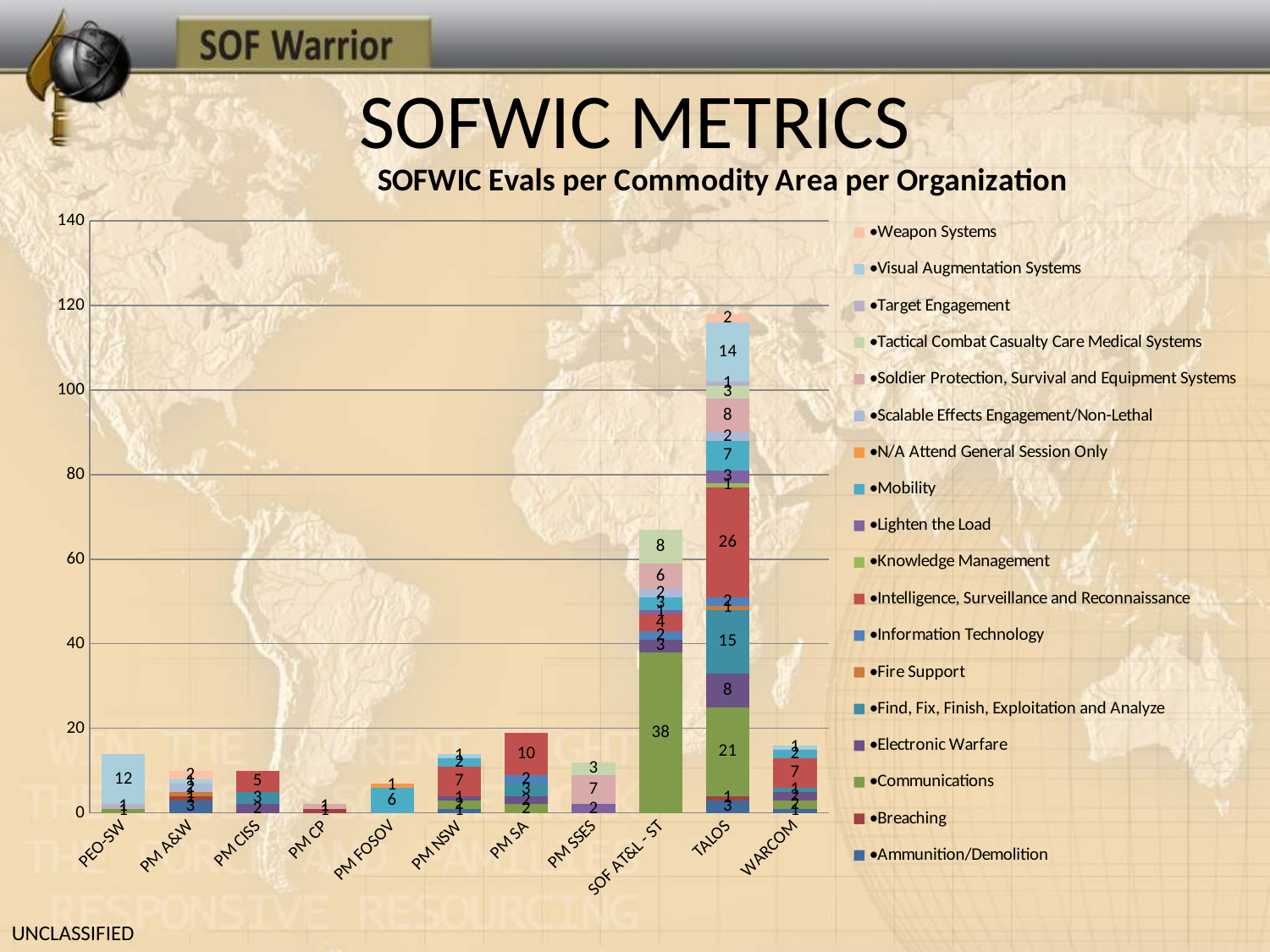
What is the Visual Augmentation Systems value for TALOS? 14 Which organization has the tallest stacked bar? TALOS What is the Communications value for SOF AT&L - ST? 38 What is the difference between the Communications value for SOF AT&L - ST (38) and for TALOS (21)? 17 How many organizations are shown along the x axis? 11 What kind of chart is shown on the slide? Stacked bar chart How many commodity areas does the legend list? 18 Which has the larger total, PM SA or PM CISS? PM SA Which organization has the shortest stacked bar? PM CP What is the Visual Augmentation Systems value for PEO-SW? 12 Is the total for TALOS greater or less than 100? greater Is the total for SOF AT&L - ST greater or less than 80? less